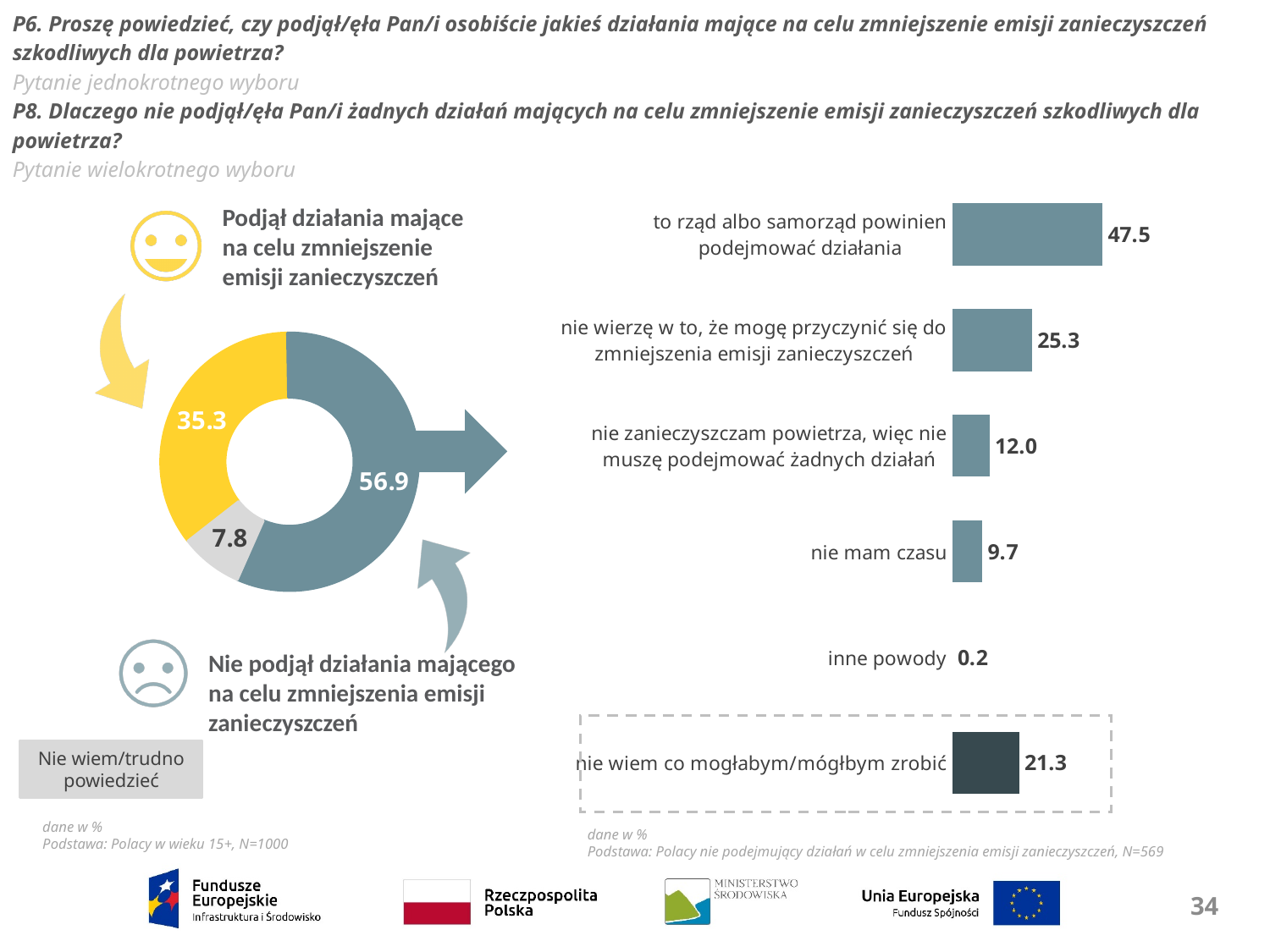
In the donut chart on the left, what share of respondents did not take action to reduce emissions (Nie podjął działania)? 56.9 In the bar chart on the right, what is the value for 'nie mam czasu'? 9.7 In the bar chart on the right, which reason has the lowest value? inne powody In the bar chart on the right, which is larger: 'nie wierzę w to, że mogę przyczynić się do zmniejszenia emisji zanieczyszczeń' or 'nie zanieczyszczam powietrza, więc nie muszę podejmować żadnych działań'? nie wierzę w to, że mogę przyczynić się do zmniejszenia emisji zanieczyszczeń In the donut chart on the left, which segment is the largest? Nie podjął działania (56.9) In the bar chart on the right, what is the difference between 'to rząd albo samorząd powinien podejmować działania' and 'nie wierzę w to, że mogę przyczynić się do zmniejszenia emisji zanieczyszczeń'? 22.2 In the donut chart on the left, what is the difference between the 'Nie podjął działania' and 'Podjął działania' segments? 21.6 In the donut chart on the left, what value is shown for 'Nie wiem/trudno powiedzieć'? 7.8 In the bar chart on the right, what is the value for 'nie wiem co mogłabym/mógłbym zrobić'? 21.3 In the donut chart on the left, what value is shown for the yellow segment (Podjął działania)? 35.3 In the bar chart on the right, what is the value for 'to rząd albo samorząd powinien podejmować działania'? 47.5 How many categories are shown in the bar chart on the right? 6